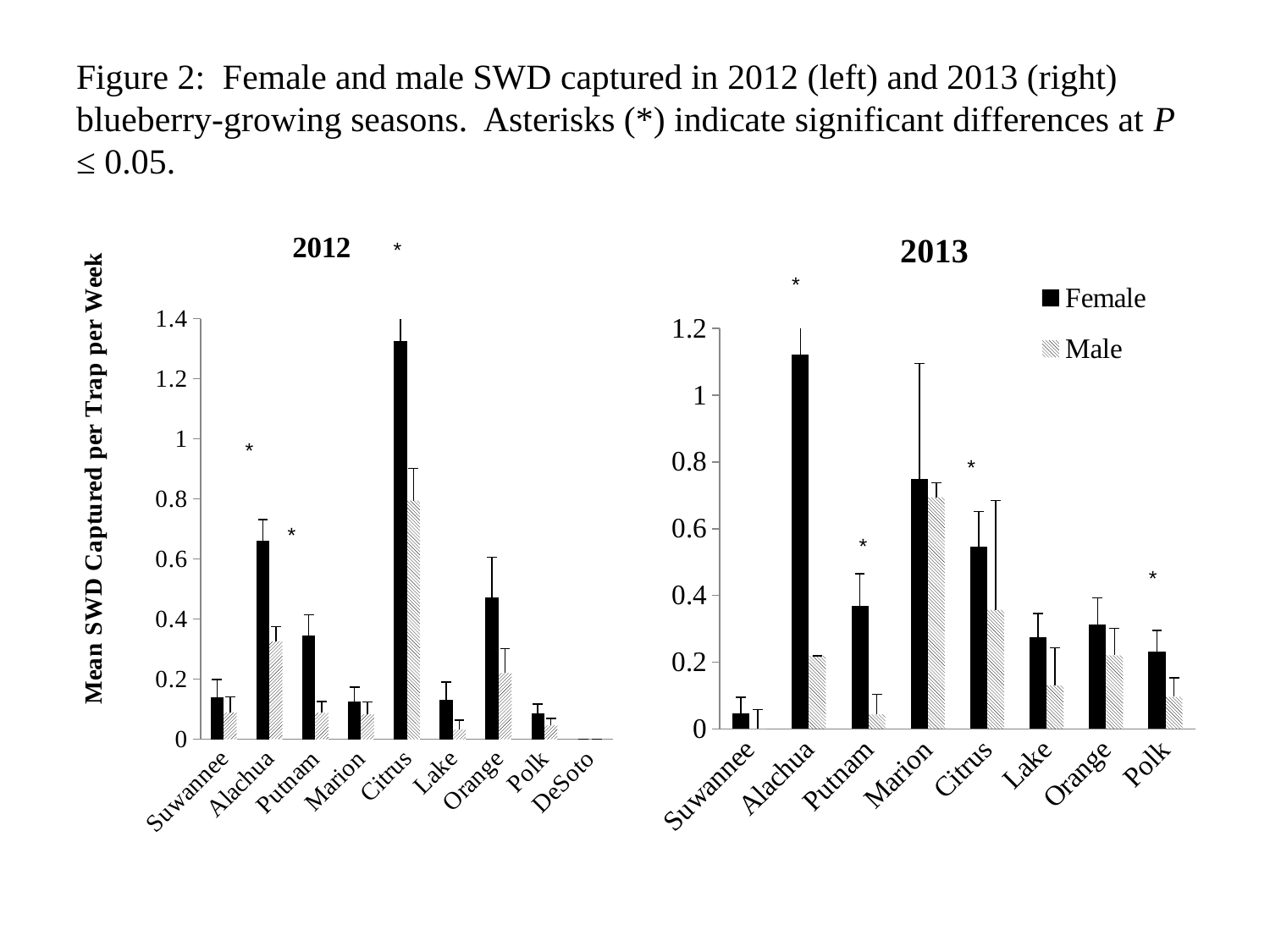
How many counties are shown on the x axis of the 2012 chart? 9 How many counties are shown on the x axis of the 2013 chart? 8 In the 2013 chart, which county has the highest Female value? Alachua In the 2012 chart, which is larger for Alachua, the Female value or the Male value? Female In the 2012 chart, which county has the lowest Female value? DeSoto What kind of chart is the 2012 chart on the left? bar chart In the 2013 chart, is the Male value for Putnam greater or less than 0.2? less In the 2013 chart, is the Female value for Alachua greater or less than 1? greater How many series does the legend on the 2013 chart list? 2 In the 2012 chart, is the Female value for Citrus greater or less than 1.2? greater What is the label on the y axis of the 2012 chart? Mean SWD Captured per Trap per Week In the 2012 chart, which county has the highest Female value? Citrus